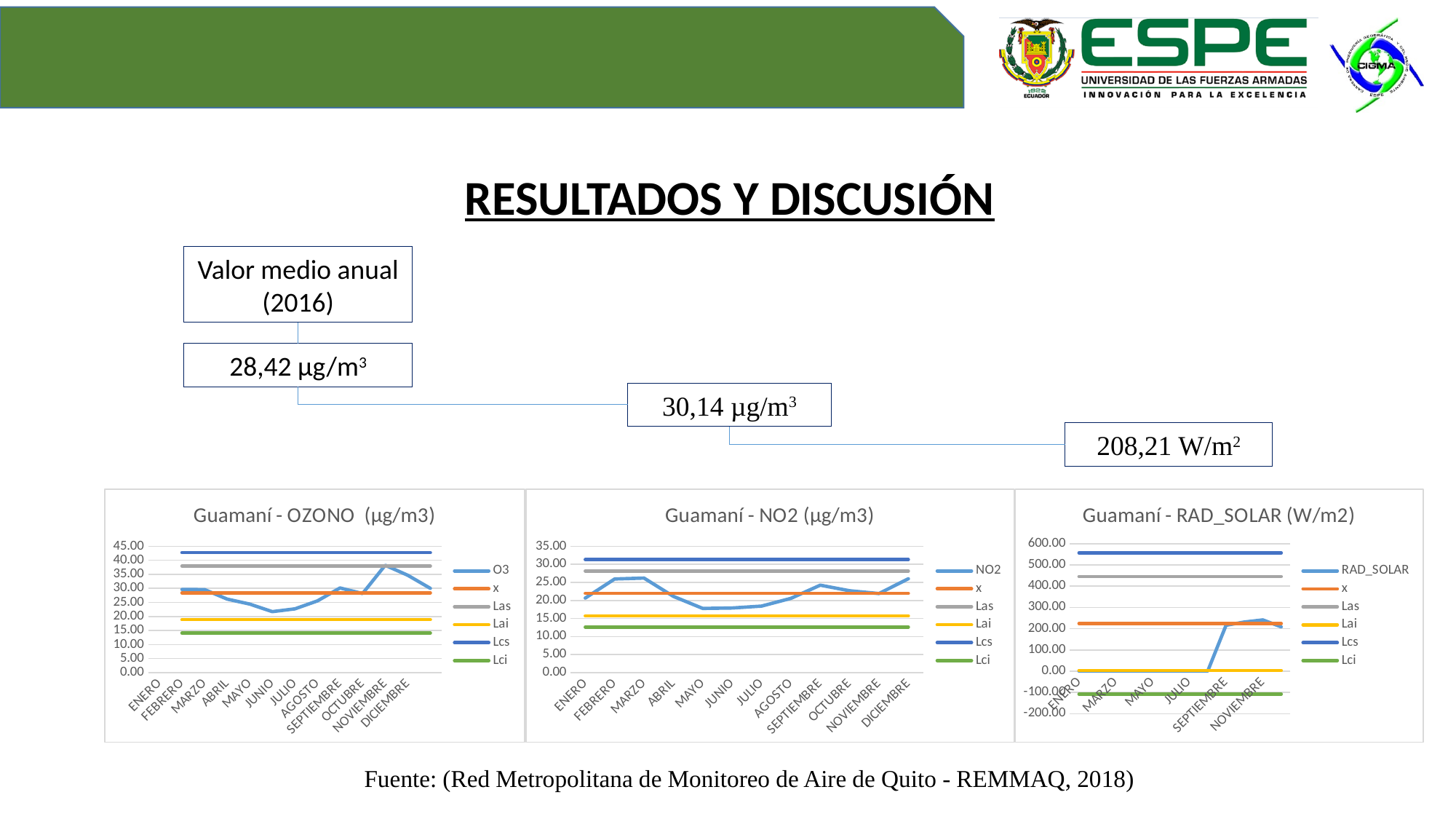
How many months are shown on the x axis of the Guamaní - OZONO (µg/m3) chart? 12 In the Guamaní - OZONO (µg/m3) chart, which month has the highest O3 value? NOVIEMBRE What kind of chart is the Guamaní - OZONO (µg/m3) chart? line chart In the Guamaní - OZONO (µg/m3) chart, is the O3 value for JUNIO greater or less than 25.00? less In the Guamaní - NO2 (µg/m3) chart, is the NO2 value for FEBRERO greater or less than 20.00? greater In the Guamaní - OZONO (µg/m3) chart, which month has the lowest O3 value? JUNIO In the Guamaní - OZONO (µg/m3) chart, does the O3 line rise or fall from FEBRERO to JUNIO? fall In the Guamaní - NO2 (µg/m3) chart, is the NO2 value for MAYO greater or less than 20.00? less How many series does the legend of the Guamaní - NO2 (µg/m3) chart list? 6 In the Guamaní - NO2 (µg/m3) chart, does the NO2 line rise or fall from MAYO to DICIEMBRE? rise What is the title of the middle chart on the slide? Guamaní - NO2 (µg/m3)